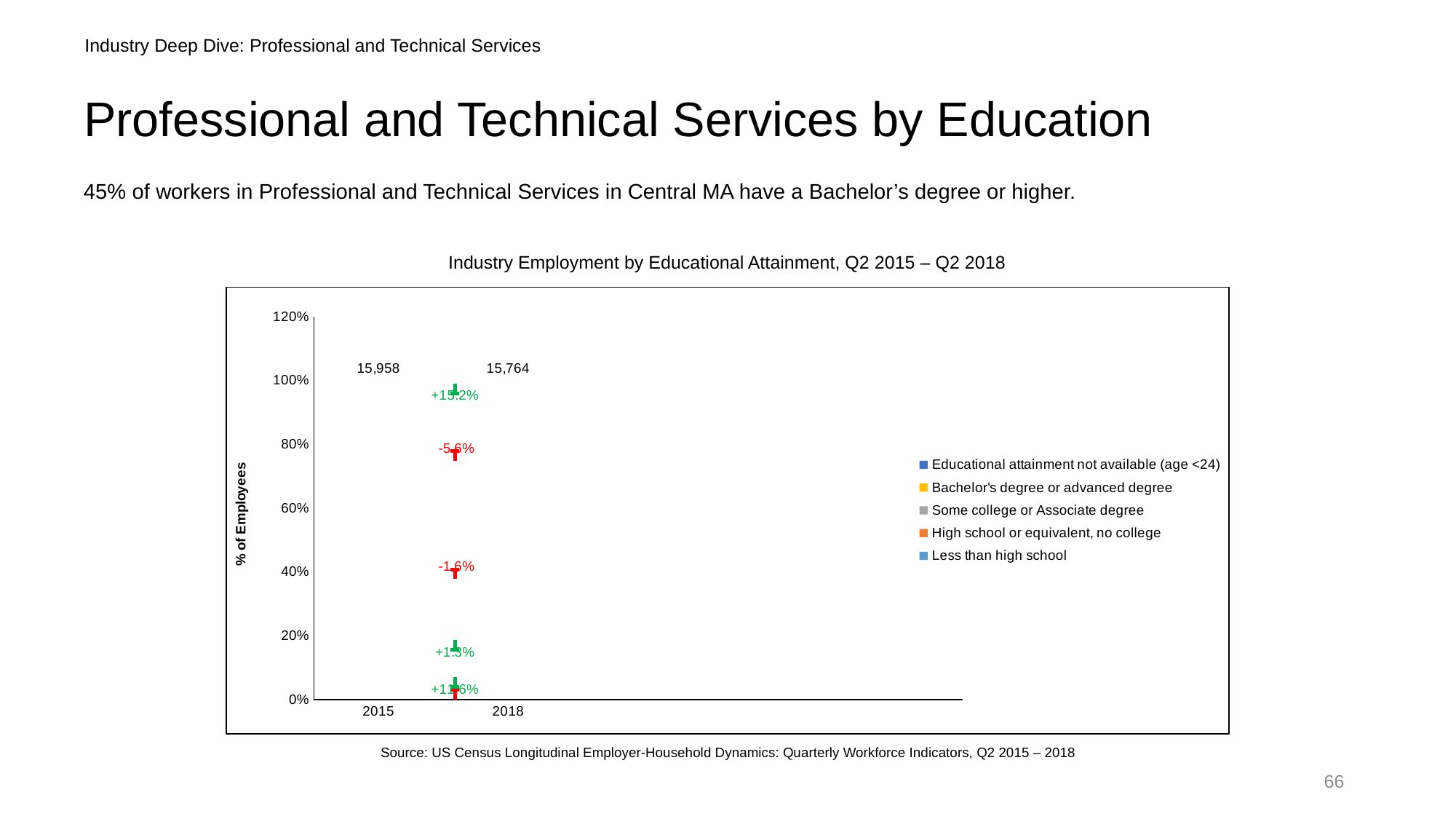
What is the difference between the total employment figures printed for 2015 and 2018? 194 What is the label on the y axis of the chart? % of Employees Is the total employment figure printed for 2018 greater or less than 15,900? less Does the total employment figure printed on the chart rise or fall from 2015 to 2018? fall What is the highest value shown on the y axis of the chart? 120% How many series does the chart's legend list? 5 What is the title of the chart? Industry Employment by Educational Attainment, Q2 2015 – Q2 2018 What total employment figure is printed above the 2015 bar? 15,958 What total employment figure is printed above the 2018 bar? 15,764 Which year has the higher total employment figure printed on the chart, 2015 or 2018? 2015 How many years are shown on the x axis of the chart? 2